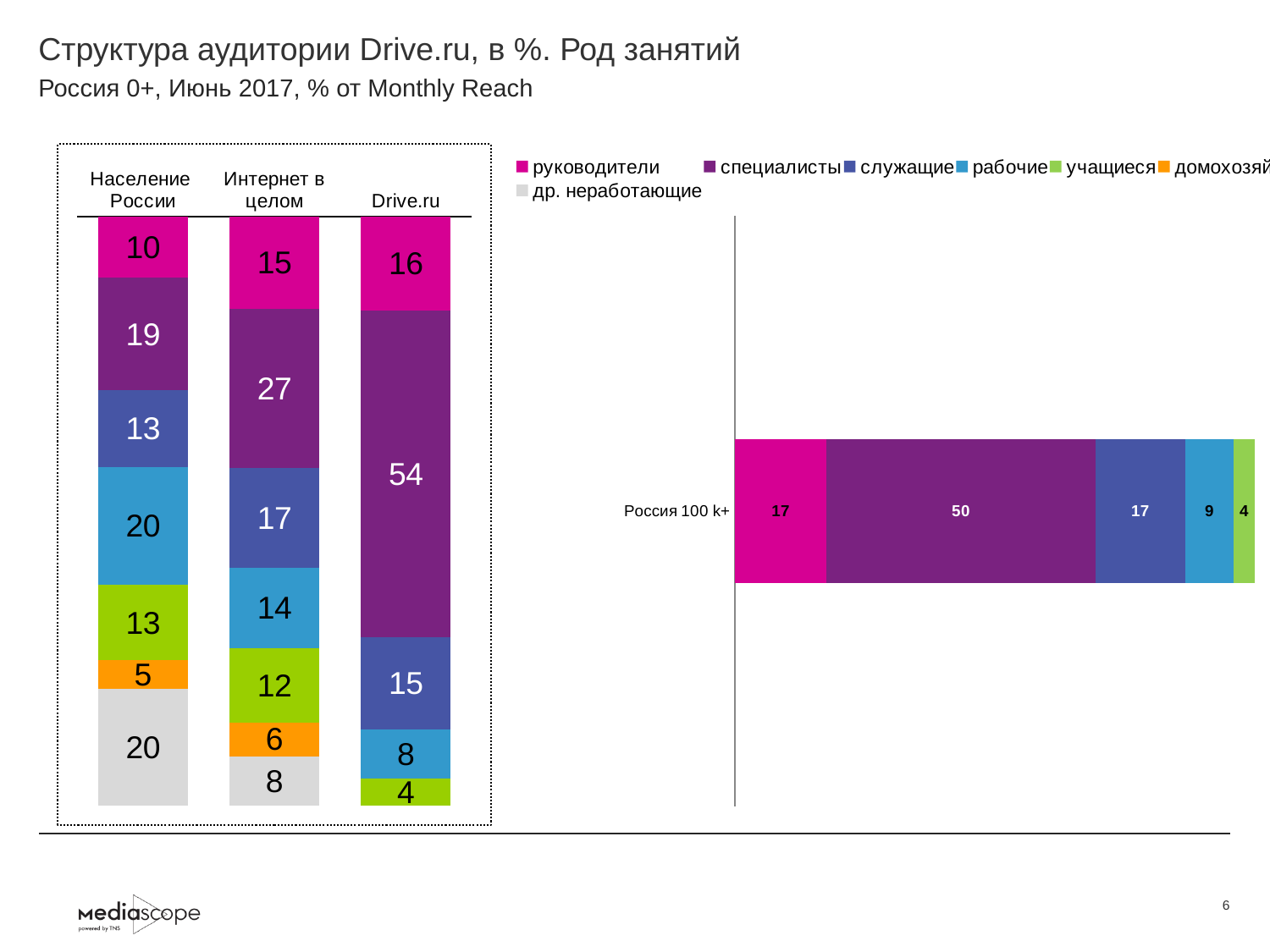
In the left chart, which is larger: the рабочие value for Население России or for Интернет в целом? Население России What kind of chart is the left chart? Stacked bar chart In the right chart, what is the total of the Россия 100 k+ stacked bar? 97 How many bars (categories) does the left chart show? 3 In the left chart, which bar has the highest value for специалисты? Drive.ru In the left chart, what is the total of the Drive.ru stacked bar? 97 In the left chart, what is the value for специалисты in the Drive.ru bar? 54 In the left chart, what is the value for руководители in the Население России bar? 10 In the left chart, what is the value for др. неработающие in the Интернет в целом bar? 8 In the left chart, what is the difference between the специалисты values for Drive.ru and Интернет в целом? 27 How many series does the legend list? 7 In the right chart, what is the value for специалисты in the Россия 100 k+ bar? 50